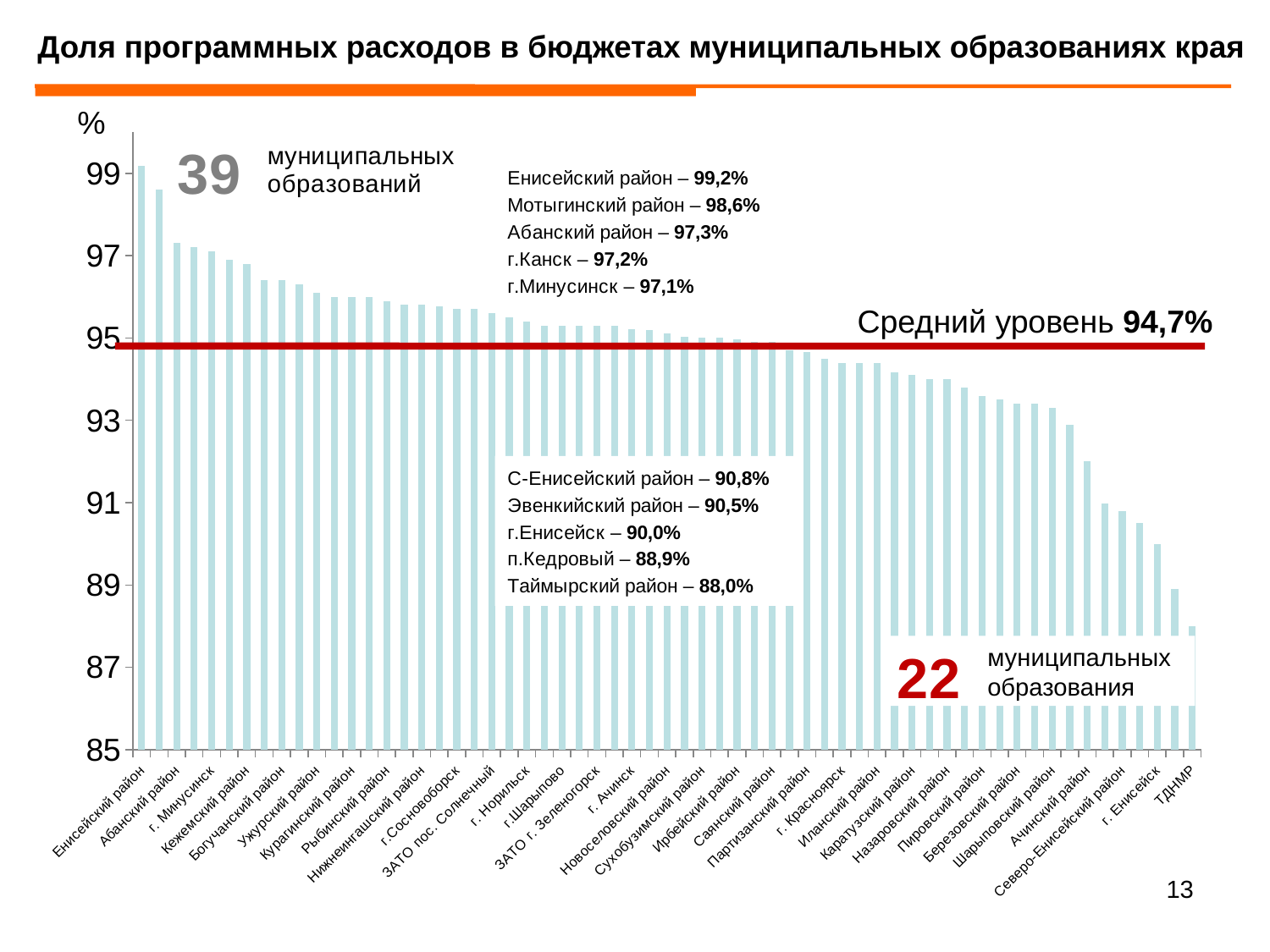
What is the average level (Средний уровень) shown on the chart? 94,7% Is the value for Пировский район greater or less than 95? less What is the value for Енисейский район? 99,2% How many municipalities are above the average level according to the slide? 39 What is the value for Мотыгинский район? 98,6% Which municipality has the lowest share of programme expenditures? Таймырский район Which municipality has the highest share of programme expenditures? Енисейский район What is the value for г.Канск? 97,2% What is the difference between the values for Енисейский район and Таймырский район? 11,2 percentage points Do the values rise or fall from left to right along the x axis? fall What is the value for п.Кедровый? 88,9% Which is larger, the value for Абанский район or the value for г.Канск? Абанский район